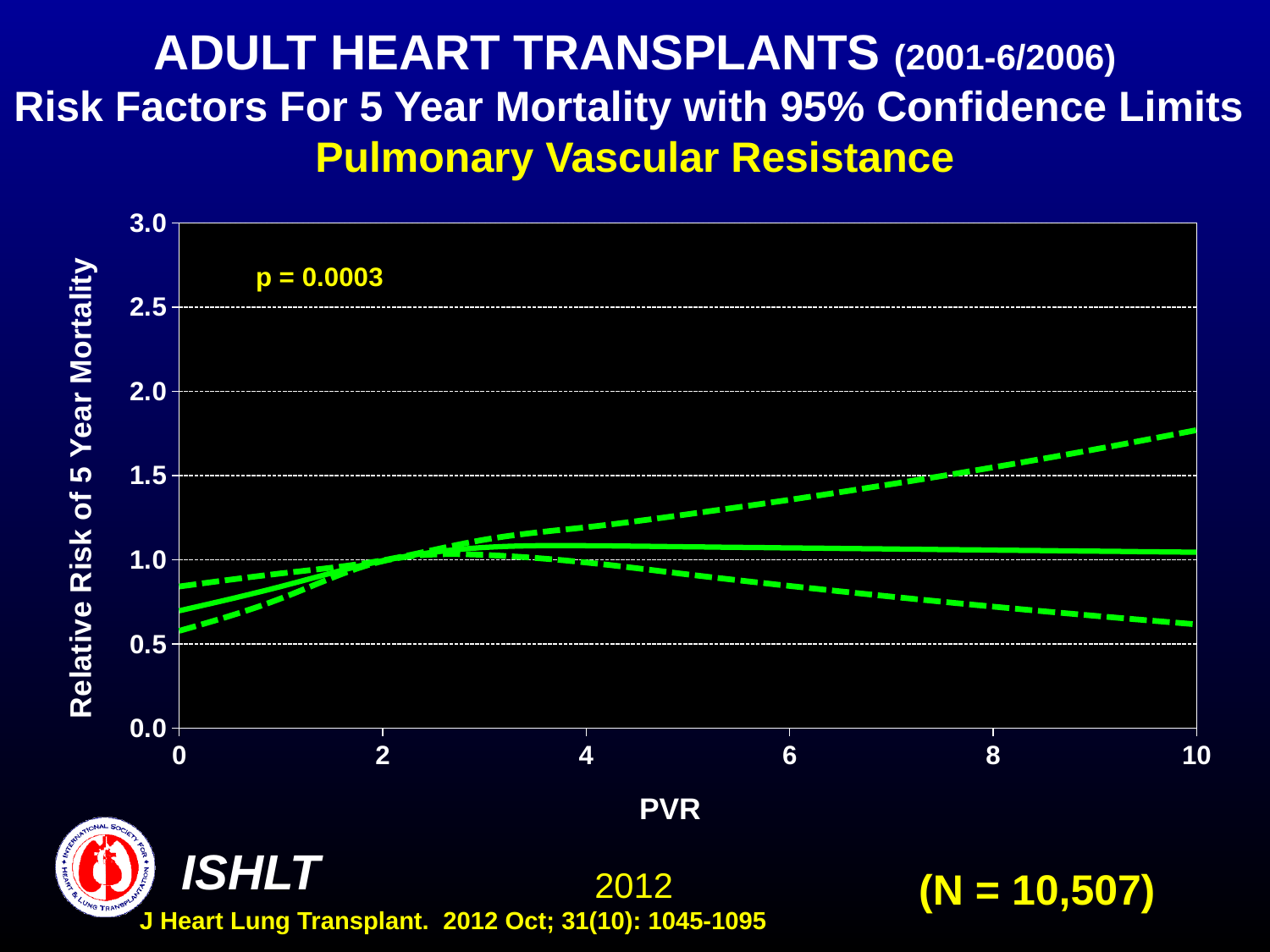
At PVR 10, which line has the larger value: the upper dashed confidence limit or the solid relative risk line? the upper dashed confidence limit Does the upper dashed confidence limit rise or fall as PVR increases from 0 to 10? rise Does the lower dashed confidence limit rise or fall as PVR increases from 4 to 10? fall How many lines are plotted on the chart? 3 Is the value of the upper dashed confidence limit at PVR 0 greater or less than 1.0? less Is the value of the lower dashed confidence limit at PVR 10 greater or less than 0.5? greater What p-value is printed on the chart? p = 0.0003 Is the value of the upper dashed confidence limit at PVR 10 greater or less than 1.5? greater What is the N value shown on the slide? N = 10,507 What kind of chart is shown on the slide? line chart